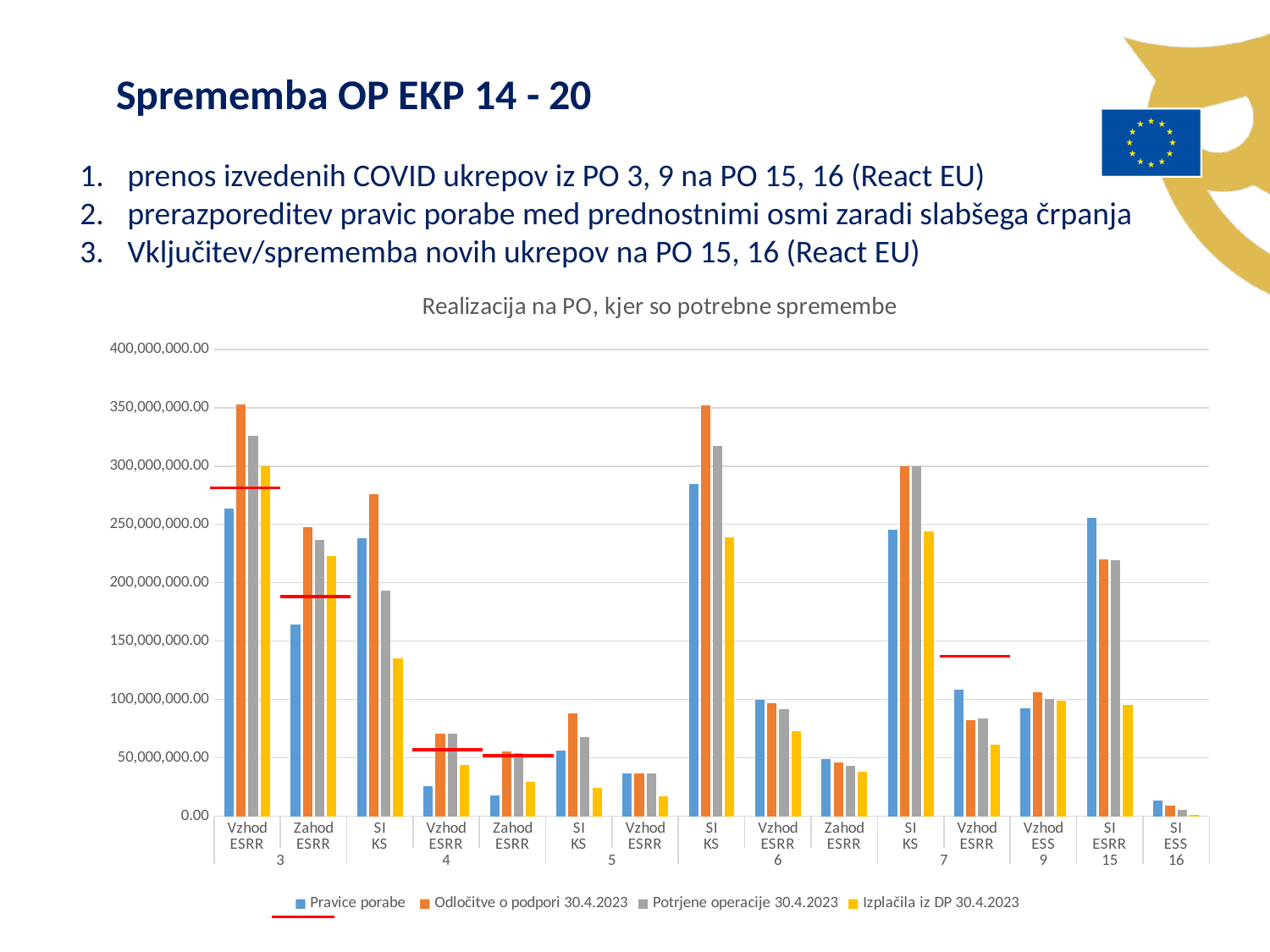
How many series does the chart legend list? 4 What type of chart is shown on the slide? bar chart Is the Pravice porabe value for Vzhod ESRR in PO 3 greater or less than 250,000,000.00? greater Is the Izplačila iz DP 30.4.2023 value for SI KS in PO 5 greater or less than 250,000,000.00? less Which category group has the lowest Pravice porabe value? SI ESS (16) What is the title of the chart? Realizacija na PO, kjer so potrebne spremembe How many category groups (bar clusters) are plotted along the x axis? 15 For Vzhod ESRR in PO 7, which is larger: Pravice porabe or Odločitve o podpori 30.4.2023? Pravice porabe Which legend entry is shown in yellow? Izplačila iz DP 30.4.2023 Is the Pravice porabe value for SI KS in PO 5 greater or less than 250,000,000.00? less